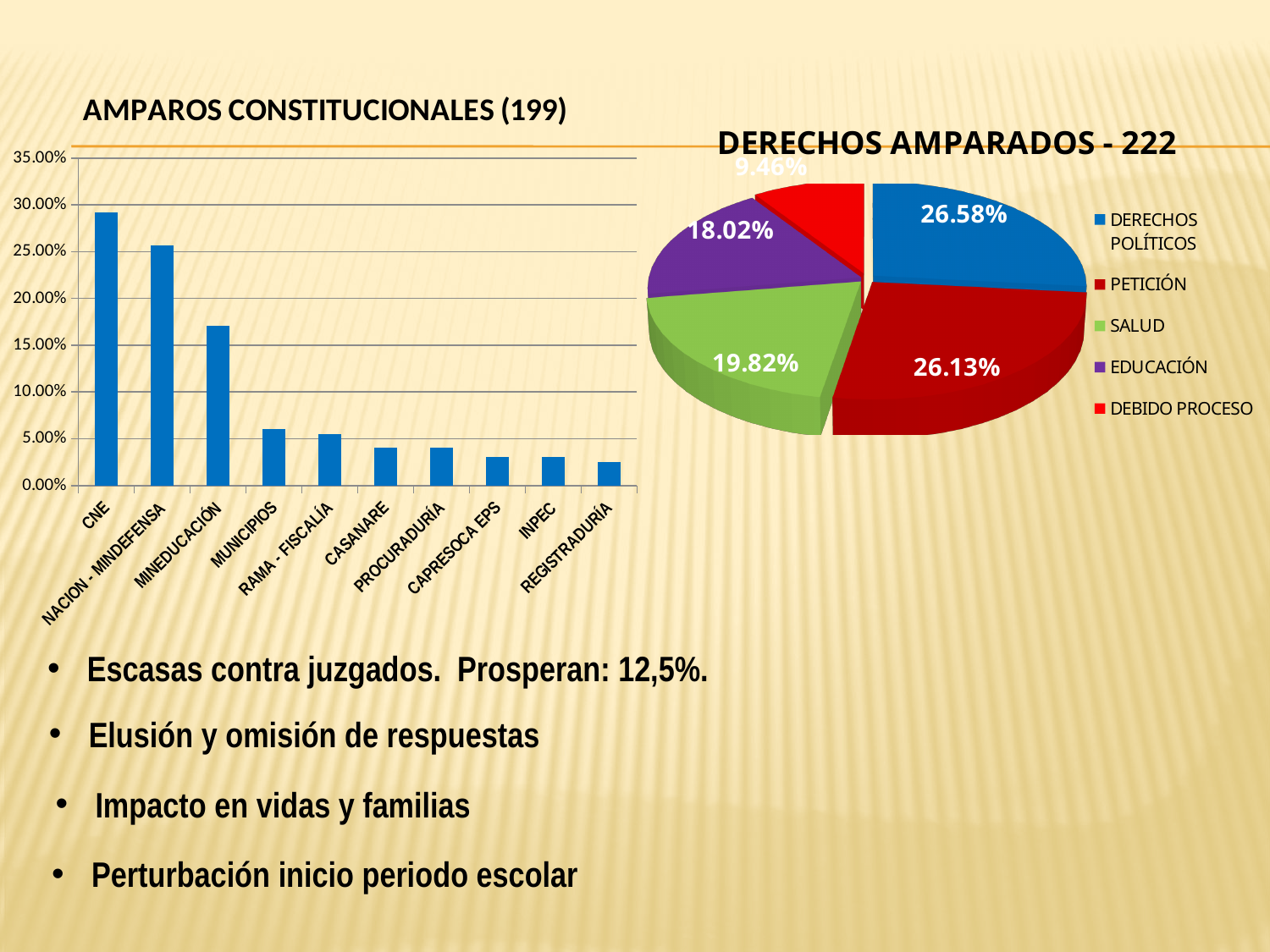
In the DERECHOS AMPARADOS - 222 chart, what is the difference between DERECHOS POLÍTICOS and PETICIÓN? 0.45% In the DERECHOS AMPARADOS - 222 chart, what share does SALUD have? 19.82% In the AMPAROS CONSTITUCIONALES (199) chart, what kind of chart is shown? Bar chart In the AMPAROS CONSTITUCIONALES (199) chart, how many categories are plotted? 10 In the AMPAROS CONSTITUCIONALES (199) chart, is the value for CNE greater or less than 25.00%? greater In the AMPAROS CONSTITUCIONALES (199) chart, which category has the highest value? CNE In the DERECHOS AMPARADOS - 222 chart, what is the value for EDUCACIÓN? 18.02% In the AMPAROS CONSTITUCIONALES (199) chart, which is larger, the value for MINEDUCACIÓN or the value for MUNICIPIOS? MINEDUCACIÓN In the AMPAROS CONSTITUCIONALES (199) chart, do the values rise or fall from left to right along the x axis? Fall In the DERECHOS AMPARADOS - 222 chart, which slice is the smallest? DEBIDO PROCESO In the AMPAROS CONSTITUCIONALES (199) chart, which category has the lowest value? REGISTRADURÍA In the AMPAROS CONSTITUCIONALES (199) chart, is the value for MUNICIPIOS greater or less than 10.00%? less